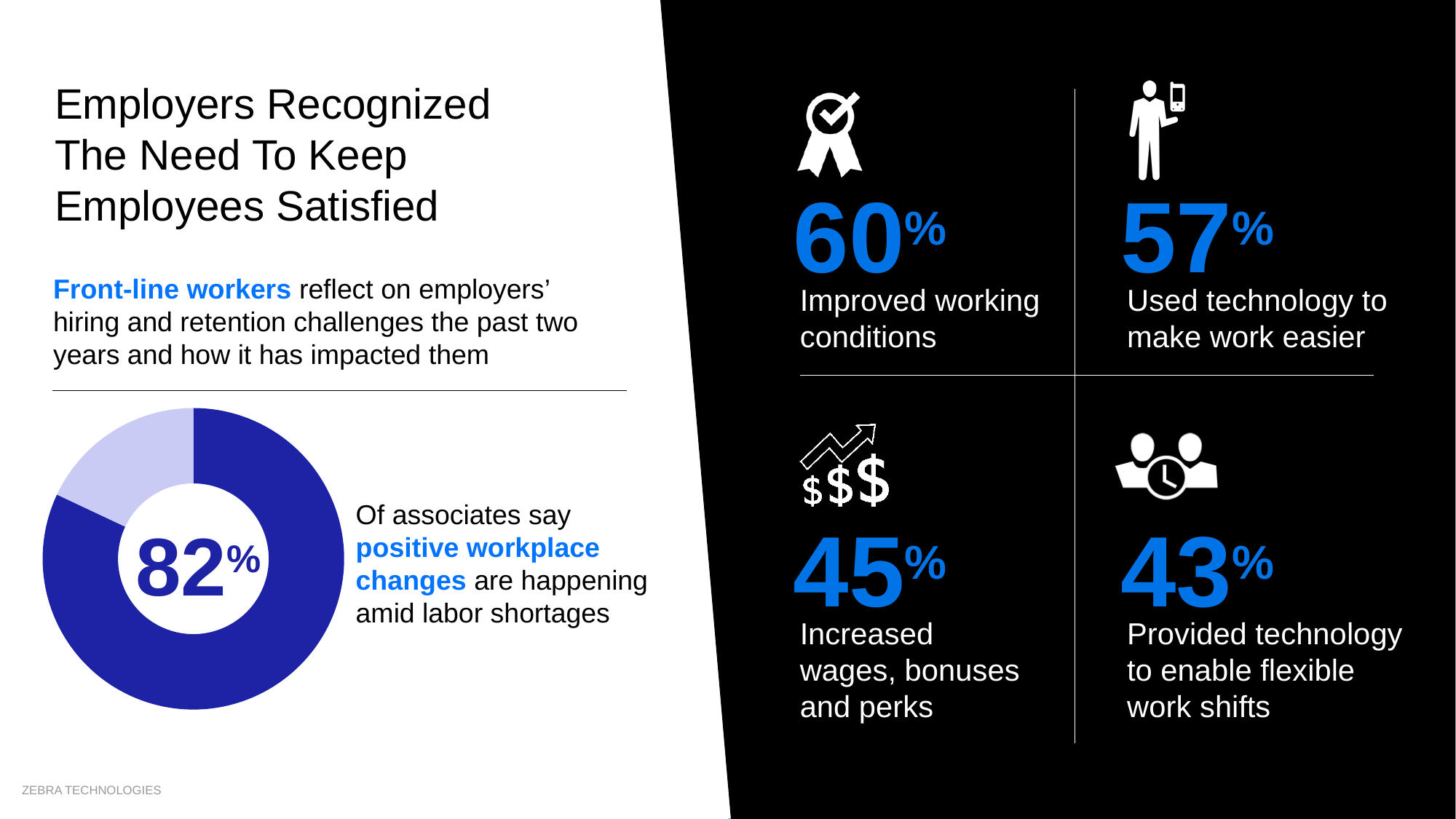
Is the value shown in the donut chart greater or less than 50%? greater What share of the donut chart does the light blue segment represent? 18% What percentage is printed in the centre of the donut chart? 82% What colour is the segment of the donut chart that represents 82%? dark blue What kind of chart is shown on the left of the slide? donut chart What share of the donut chart does the dark blue segment represent? 82% How many segments does the donut chart have? 2 According to the text beside the donut chart, what does the 82% represent? Associates who say positive workplace changes are happening amid labor shortages Which segment of the donut chart is larger, the dark blue one or the light blue one? the dark blue one